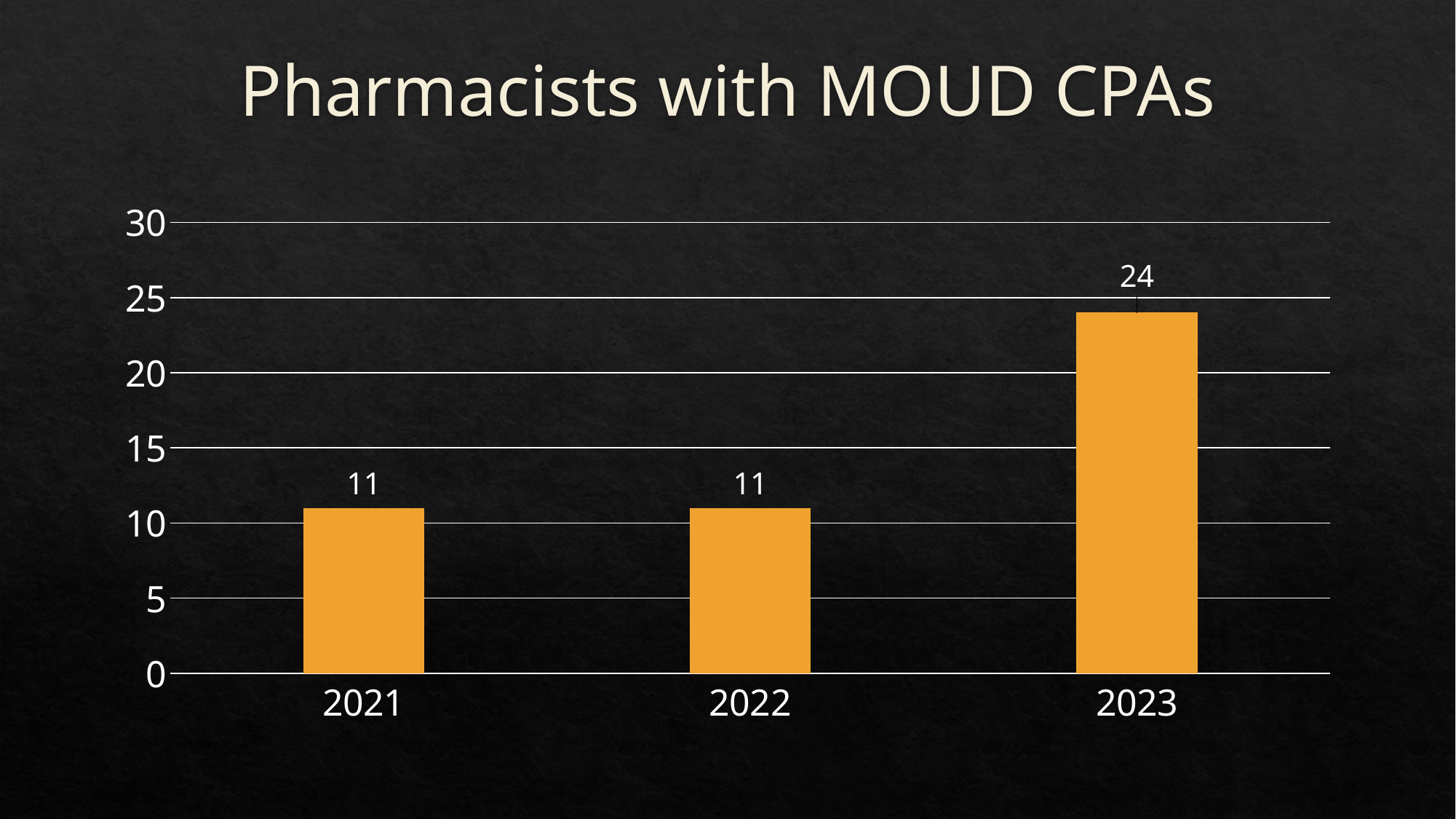
How many years are shown on the x axis? 3 Which is larger, the value for 2021 or the value for 2023? 2023 Is the value for 2021 greater or less than 15? less What is the difference between the values for 2023 and 2022? 13 What kind of chart is shown? bar chart What is the value for 2022? 11 What is the title of the chart? Pharmacists with MOUD CPAs What is the value for 2023? 24 Which year has the highest value? 2023 Do the values rise or fall from 2022 to 2023? rise Is the value for 2023 greater or less than 20? greater What is the value for 2021? 11